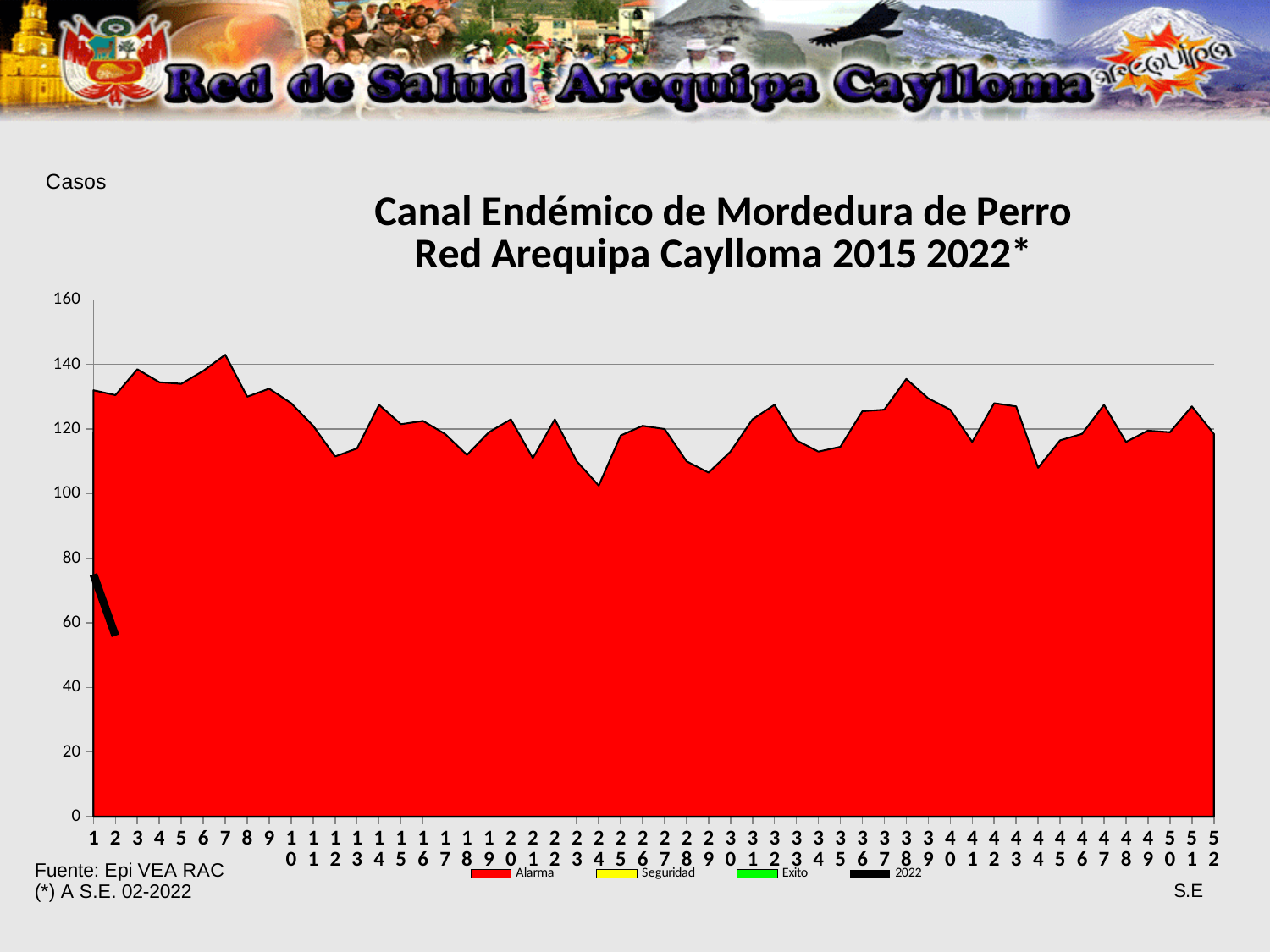
What kind of chart is shown on the slide? area chart Do the Alarma values rise or fall from week 7 to week 12? fall What are the four entries in the chart legend? Alarma, Seguridad, Exito, 2022 Is the Alarma value at week 24 greater or less than 120? less How many epidemiological weeks (S.E.) are shown along the x axis? 52 At which week does the Alarma area reach its highest point? 7 Which is larger, the Alarma value at week 7 or at week 24? week 7 Is the Alarma value at week 7 greater or less than 120? greater How many series does the legend list? 4 Is the 2022 value at week 1 greater or less than 60? greater What is the title of the chart? Canal Endémico de Mordedura de Perro Red Arequipa Caylloma 2015 2022*